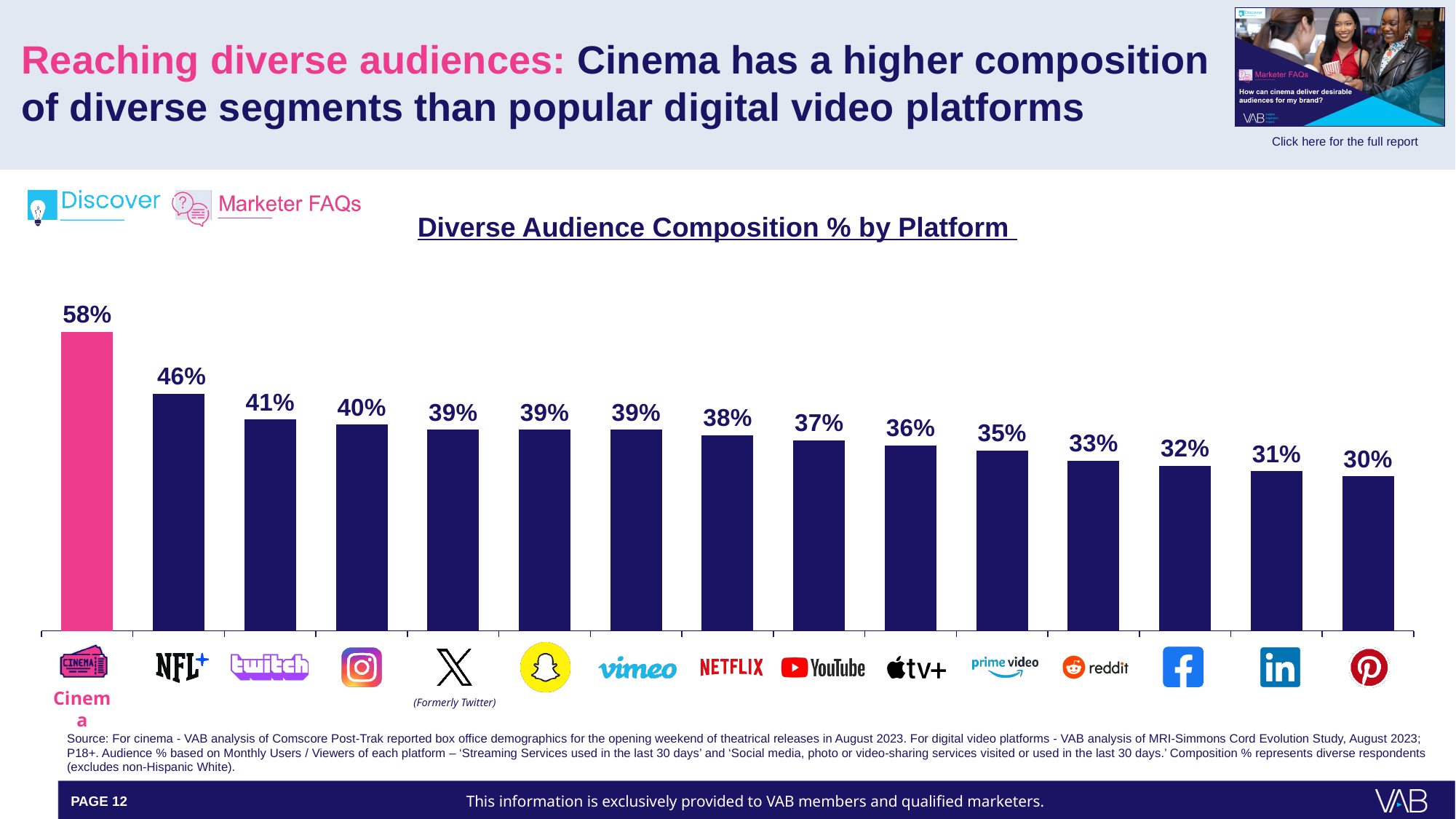
What is the diverse audience composition % for Cinema? 58% Which platform has the lowest diverse audience composition %? Pinterest What is the diverse audience composition % for Netflix? 38% What is the difference in diverse audience composition % between Twitch and Facebook? 9 percentage points What is the diverse audience composition % for YouTube? 37% How many platforms are shown in the chart? 15 Which platform has the highest diverse audience composition %? Cinema What is the difference in diverse audience composition % between Cinema and NFL+? 12 percentage points Which has a higher diverse audience composition %, Instagram or Reddit? Instagram What is the title of the chart? Diverse Audience Composition % by Platform What type of chart is used to show Diverse Audience Composition % by Platform? Bar chart What is the diverse audience composition % for Pinterest? 30%